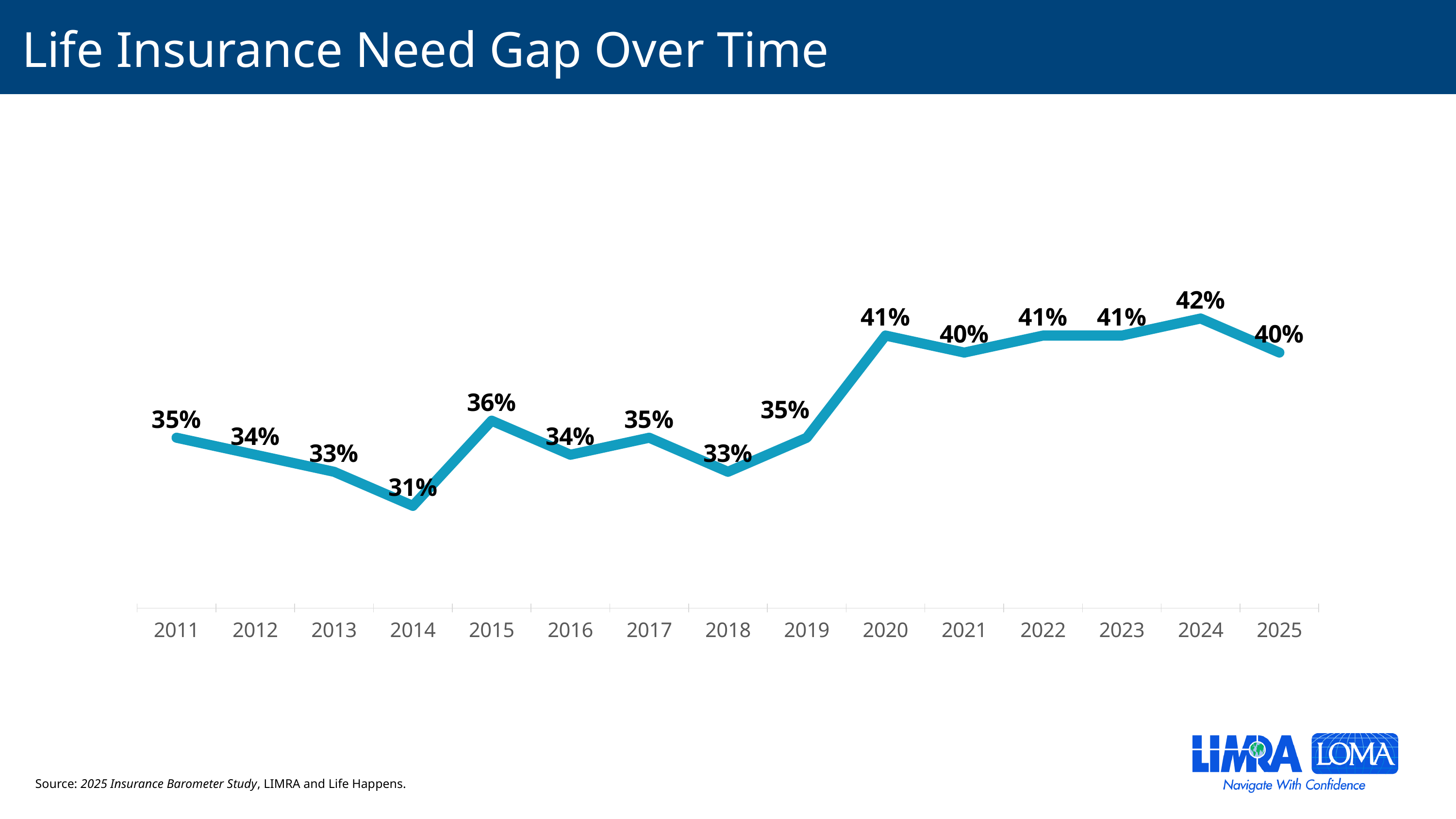
What is the life insurance need gap value for 2014? 31% What is the difference between the values for 2020 and 2019? 6% Which year has the larger value, 2015 or 2018? 2015 Which year has the highest value on the chart? 2024 What is the value shown for 2020? 41% How many years are plotted on the x axis? 15 What is the value shown for 2025? 40% Do the values generally rise or fall from 2011 to 2025? Rise What is the title of the slide? Life Insurance Need Gap Over Time What kind of chart is shown on the slide? Line chart Which year has the lowest value on the chart? 2014 What is the difference between the values for 2024 and 2014? 11%